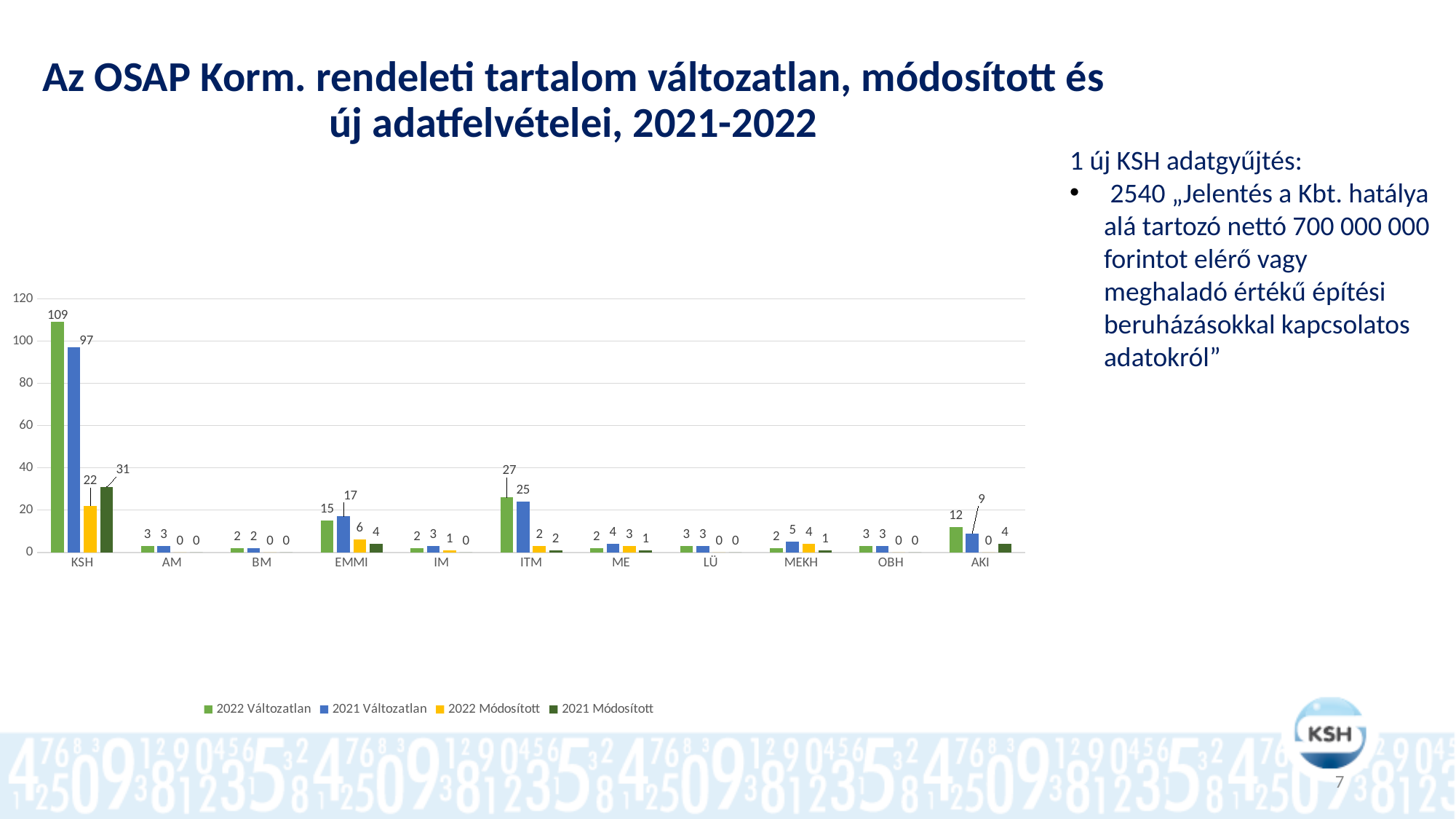
What is the value of 2021 Változatlan for EMMI? 17 Which category has the highest value for 2021 Változatlan? KSH Is the value of 2021 Változatlan for KSH greater or less than 80? greater What is the difference between the 2022 Változatlan and 2021 Változatlan values for KSH? 12 What kind of chart is shown on the slide? bar chart What is the value of 2022 Változatlan for ITM? 27 What is the value of 2022 Változatlan for KSH? 109 What is the value of 2021 Módosított for KSH? 31 How many series does the legend list? 4 Which colour represents the 2022 Módosított series? yellow How many categories are shown on the x axis? 11 Which is larger for AKI: 2022 Változatlan or 2021 Változatlan? 2022 Változatlan